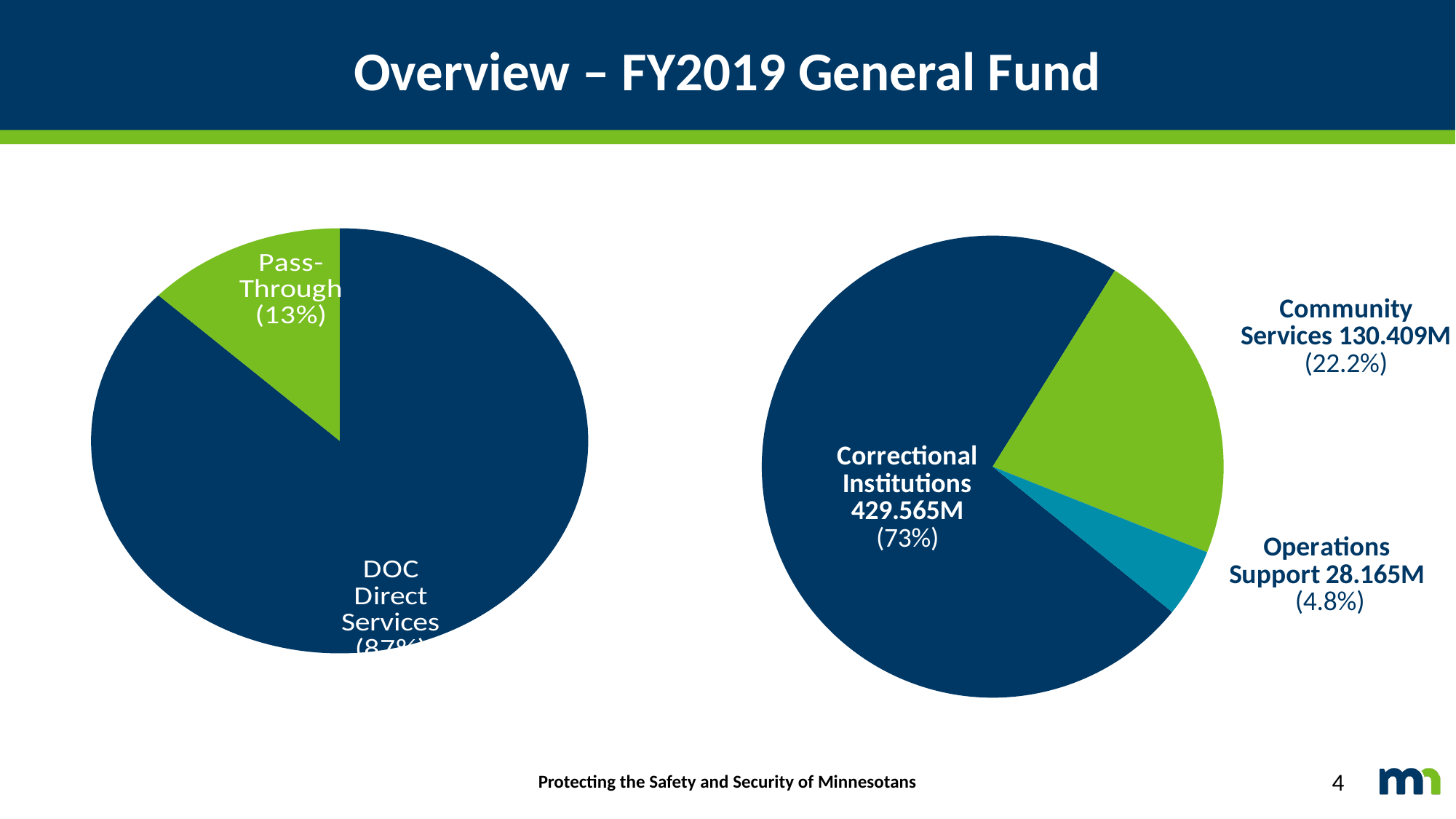
How many slices does the pie chart on the right have? 3 What kind of chart is the chart on the left of the slide? pie chart In the pie chart on the right, which category has the smallest slice? Operations Support In the pie chart on the left, which slice is larger, Pass-Through or DOC Direct Services? DOC Direct Services In the pie chart on the left, what share does DOC Direct Services have? 87% In the pie chart on the right, what is the value for Correctional Institutions? 429.565M In the pie chart on the right, what is the value for Operations Support? 28.165M In the pie chart on the left, what share does Pass-Through have? 13% In the pie chart on the right, which category has the largest slice? Correctional Institutions In the pie chart on the right, what is the value for Community Services? 130.409M In the pie chart on the right, what share does Community Services have? 22.2% How many slices does the pie chart on the left have? 2